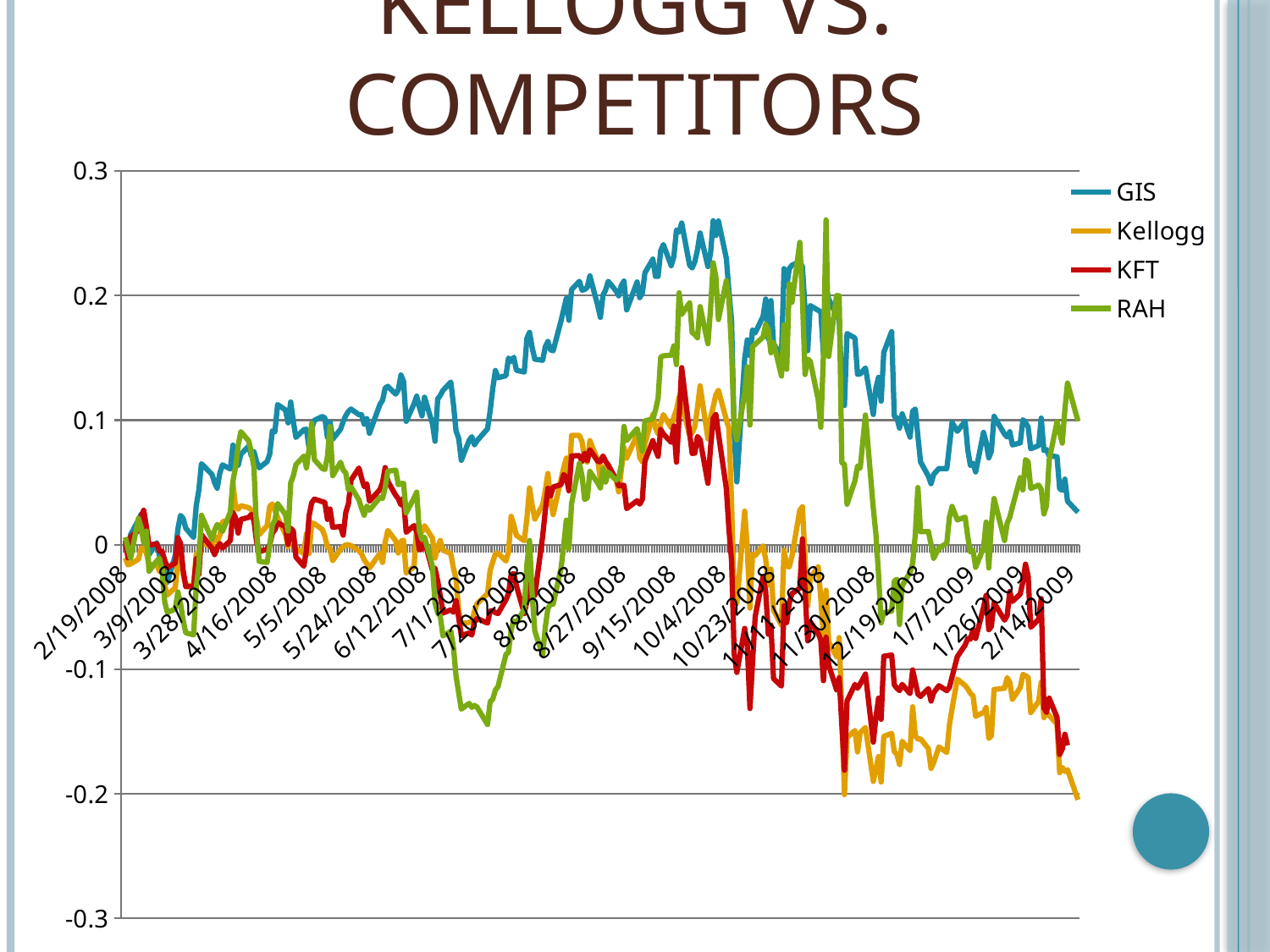
Which series are listed in the legend? GIS, Kellogg, KFT, RAH Which series reaches the lowest value anywhere on the chart? Kellogg What is the highest value shown on the vertical axis? 0.3 Is the value for GIS around 9/15/2008 greater or less than 0.2? greater How many series does the legend list? 4 What kind of chart is shown on the slide? line chart Is the value for KFT around 12/19/2008 greater or less than 0? less Is the value for Kellogg at 2/14/2009 greater or less than -0.1? less What colour is the KFT line? red Does the GIS line generally rise or fall from 2/19/2008 to 9/15/2008? rise At the right end of the chart (2/14/2009), which is higher, GIS or Kellogg? GIS